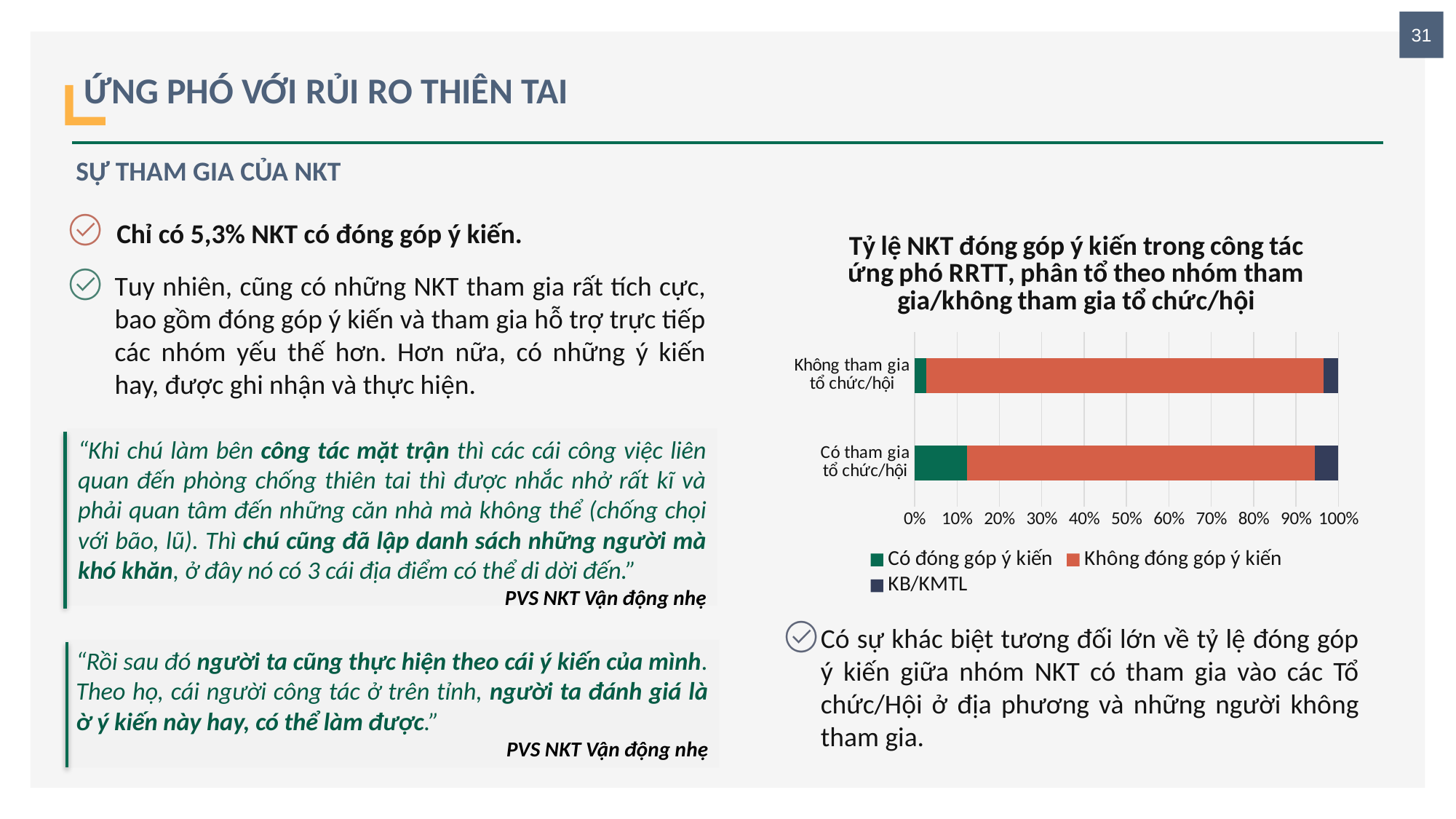
How many categories (bars) does the chart show? 2 Is the 'Có đóng góp ý kiến' share for 'Có tham gia tổ chức/hội' greater or less than 50%? less Is the 'Có đóng góp ý kiến' share for 'Không tham gia tổ chức/hội' greater or less than 10%? less Which category has the larger 'Có đóng góp ý kiến' segment: 'Có tham gia tổ chức/hội' or 'Không tham gia tổ chức/hội'? Có tham gia tổ chức/hội Which category is listed at the top of the chart? Không tham gia tổ chức/hội Is the 'Không đóng góp ý kiến' share for 'Có tham gia tổ chức/hội' greater or less than 50%? greater Which category has the larger 'Không đóng góp ý kiến' segment? Không tham gia tổ chức/hội What is the highest value shown on the chart's horizontal axis? 100% What kind of chart is shown on the slide? Stacked bar chart How many series does the chart legend list? 3 Which series is shown in green in the chart? Có đóng góp ý kiến